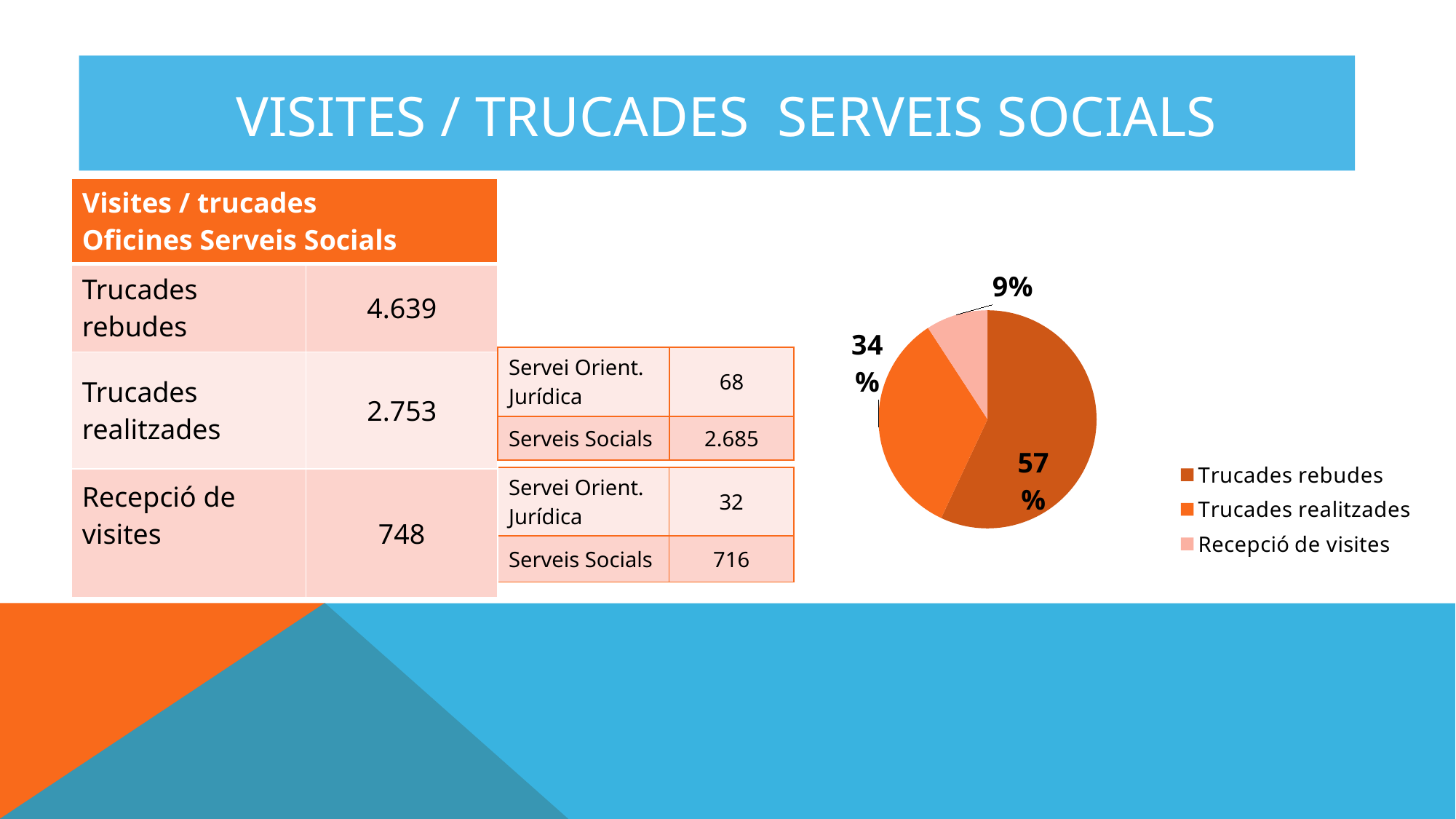
How many entries does the pie chart legend list? 3 Which slice is larger in the pie chart, Trucades realitzades or Recepció de visites? Trucades realitzades Which legend entry is shown in the lightest shade of orange in the pie chart? Recepció de visites Which category has the smallest slice in the pie chart? Recepció de visites Which category has the largest slice in the pie chart? Trucades rebudes Is the share for Trucades rebudes greater or less than 50%? greater What is the difference in percentage points between the Trucades rebudes slice and the Trucades realitzades slice? 23 What kind of chart is shown on the slide? pie chart What percentage of the pie chart does Trucades rebudes represent? 57% What percentage of the pie chart does Trucades realitzades represent? 34% What percentage of the pie chart does Recepció de visites represent? 9% How many slices does the pie chart have? 3